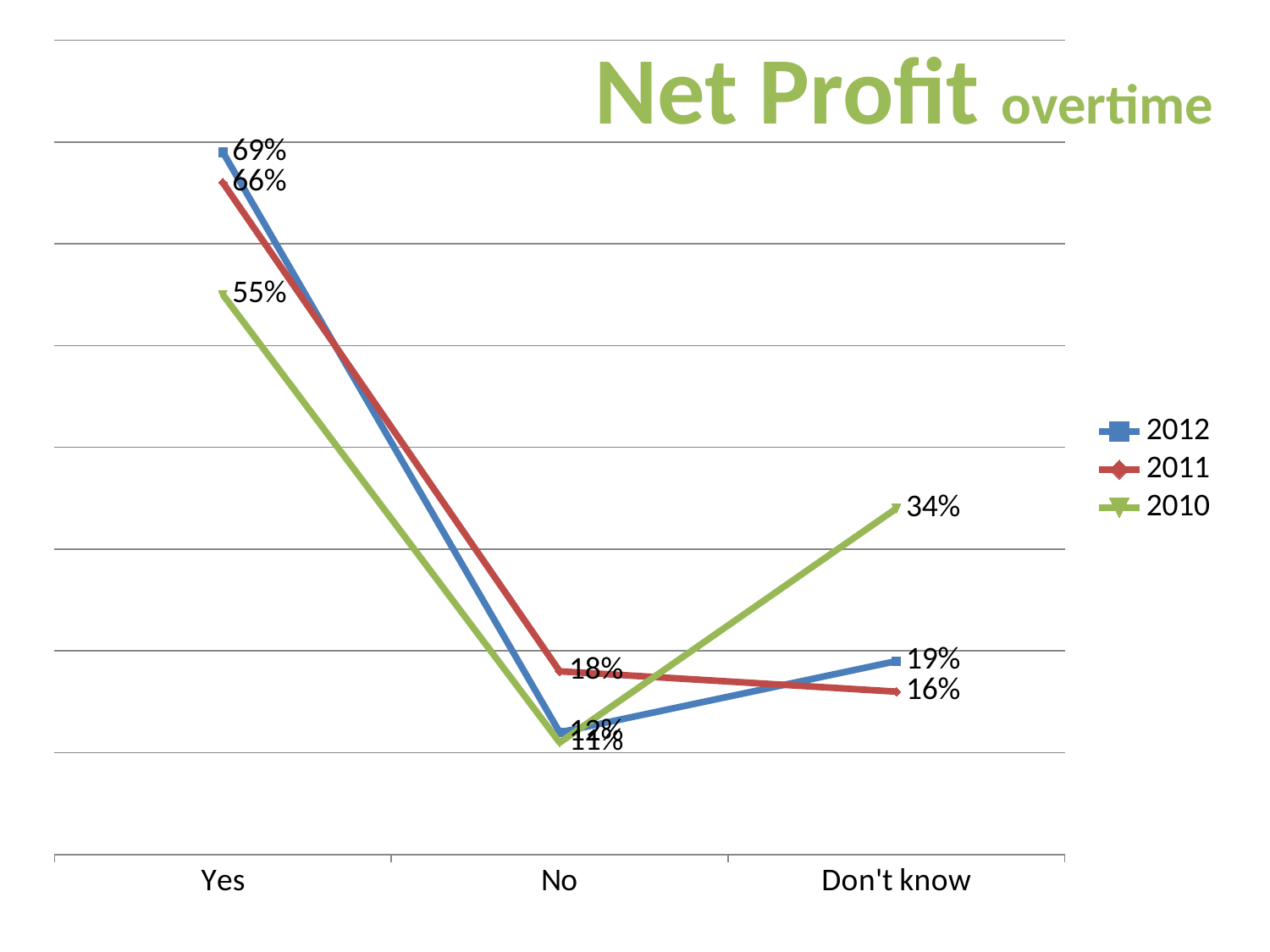
What is the difference between the 2012 and 2011 values in the Yes category? 3% What is the value for 2011 in the Don't know category? 16% What is the value for 2011 in the Yes category? 66% What is the value for 2010 in the Don't know category? 34% Does the 2011 series rise or fall from Yes to Don't know? Fall What is the value for 2011 in the No category? 18% In the Don't know category, which is larger: the 2012 value or the 2011 value? 2012 What is the value for 2010 in the Yes category? 55% How many series does the legend list? 3 Which series has the highest value in the Don't know category? 2010 What kind of chart is shown on the slide? Line chart What is the value for 2012 in the Yes category? 69%